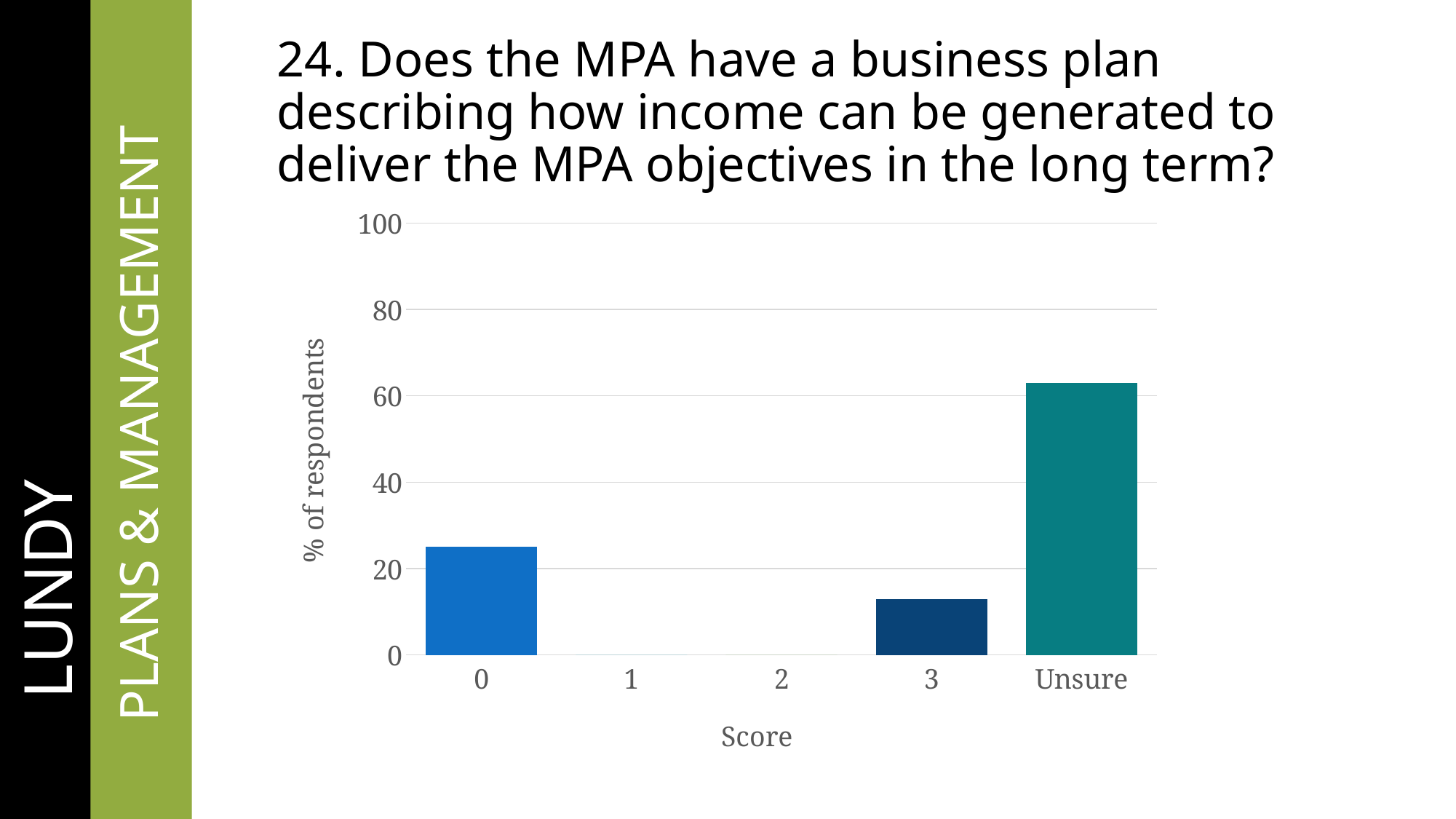
Which score category has the highest percentage of respondents? Unsure What is the label of the x axis? Score Is the value for score 3 greater or less than 20? less What is the label of the y axis? % of respondents Which is larger, the value for score 0 or the value for score 3? score 0 Is the value for score 0 greater or less than 20? greater What kind of chart is shown on the slide? bar chart What is the percentage of respondents for score 1? 0 What is the percentage of respondents for score 2? 0 How many score categories are shown on the x axis? 5 Is the value for score 0 greater or less than 40? less